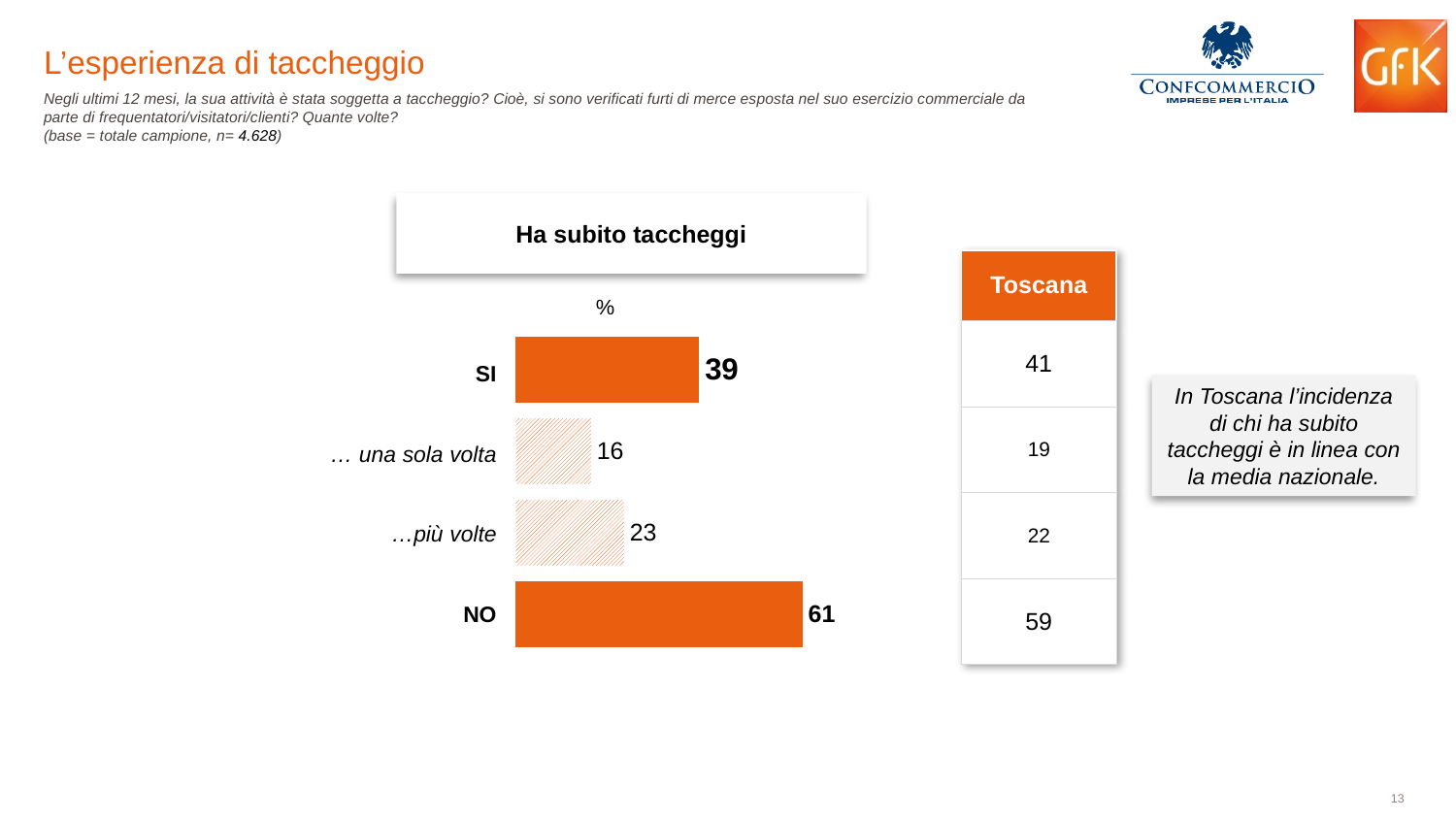
In the "Ha subito taccheggi" chart, what is the value for "…più volte"? 23 In the "Ha subito taccheggi" chart, what is the difference between the values for NO and SI? 22 In the "Ha subito taccheggi" chart, what is the value for NO? 61 How many bars are plotted in the "Ha subito taccheggi" chart? 4 In the "Ha subito taccheggi" chart, which category has the highest value? NO In the "Ha subito taccheggi" chart, which is larger, the value for "…più volte" or the value for "… una sola volta"? …più volte In the "Ha subito taccheggi" chart, what is the value for "… una sola volta"? 16 In the "Ha subito taccheggi" chart, which bars are drawn with a hatched pattern rather than solid orange? … una sola volta and …più volte In the "Ha subito taccheggi" chart, what unit is indicated above the bars? % What kind of chart is shown under the title "Ha subito taccheggi"? bar chart In the "Ha subito taccheggi" chart, which category has the lowest value? … una sola volta In the "Ha subito taccheggi" chart, what is the value for SI? 39